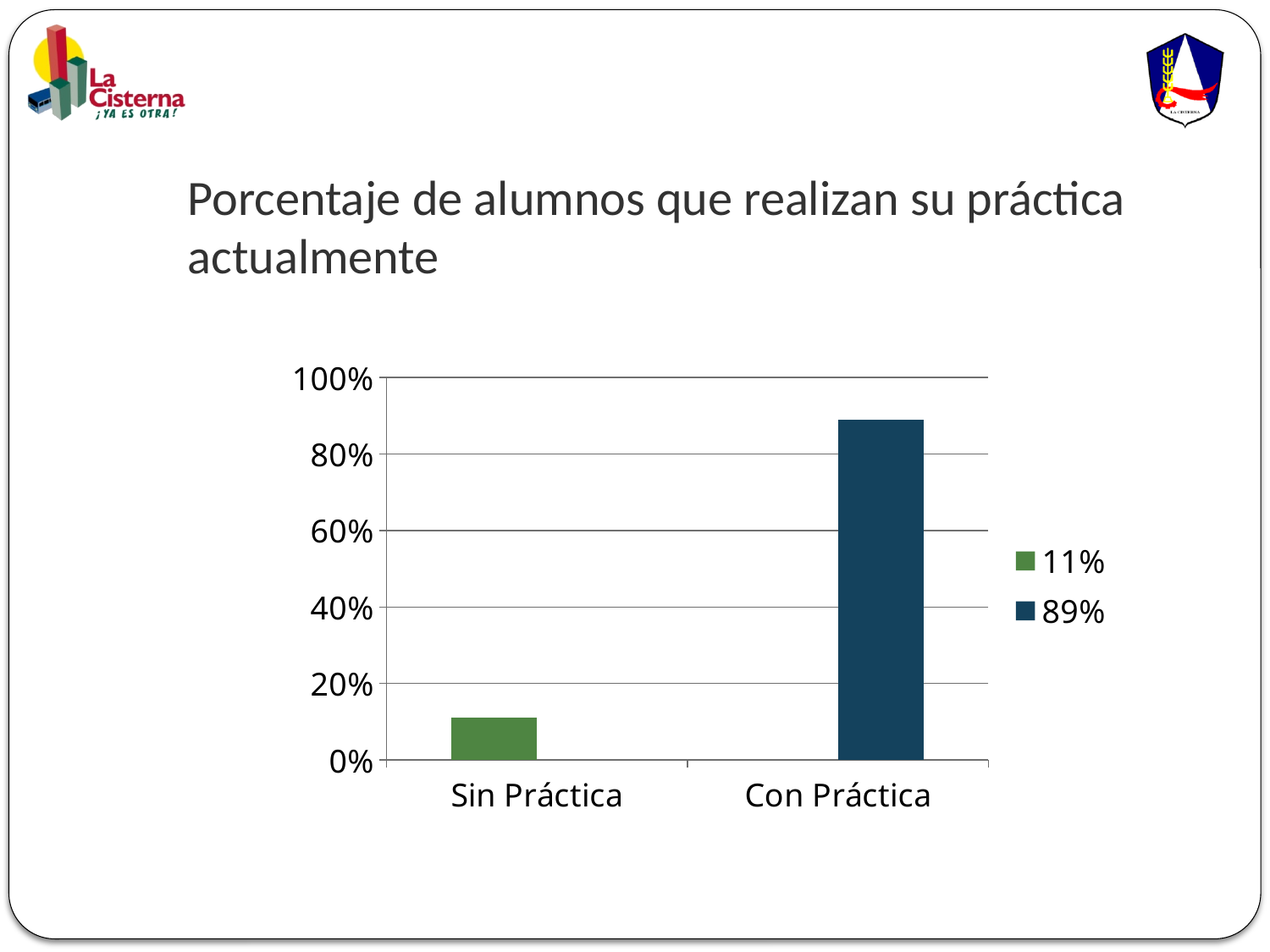
Is the value for Con Práctica greater or less than 80%? greater How many categories are shown on the x axis of the chart? 2 Which category has the highest bar in the chart? Con Práctica What is the title of the chart on the slide? Porcentaje de alumnos que realizan su práctica actualmente What percentage does the legend give for the green series? 11% Which category has the lowest bar in the chart? Sin Práctica What kind of chart is shown on the slide? bar chart What is the value for Sin Práctica according to the legend? 11% Which is larger, the bar for Sin Práctica or the bar for Con Práctica? Con Práctica What is the value for Con Práctica according to the legend? 89% Is the value for Sin Práctica greater or less than 20%? less How many entries does the chart's legend list? 2